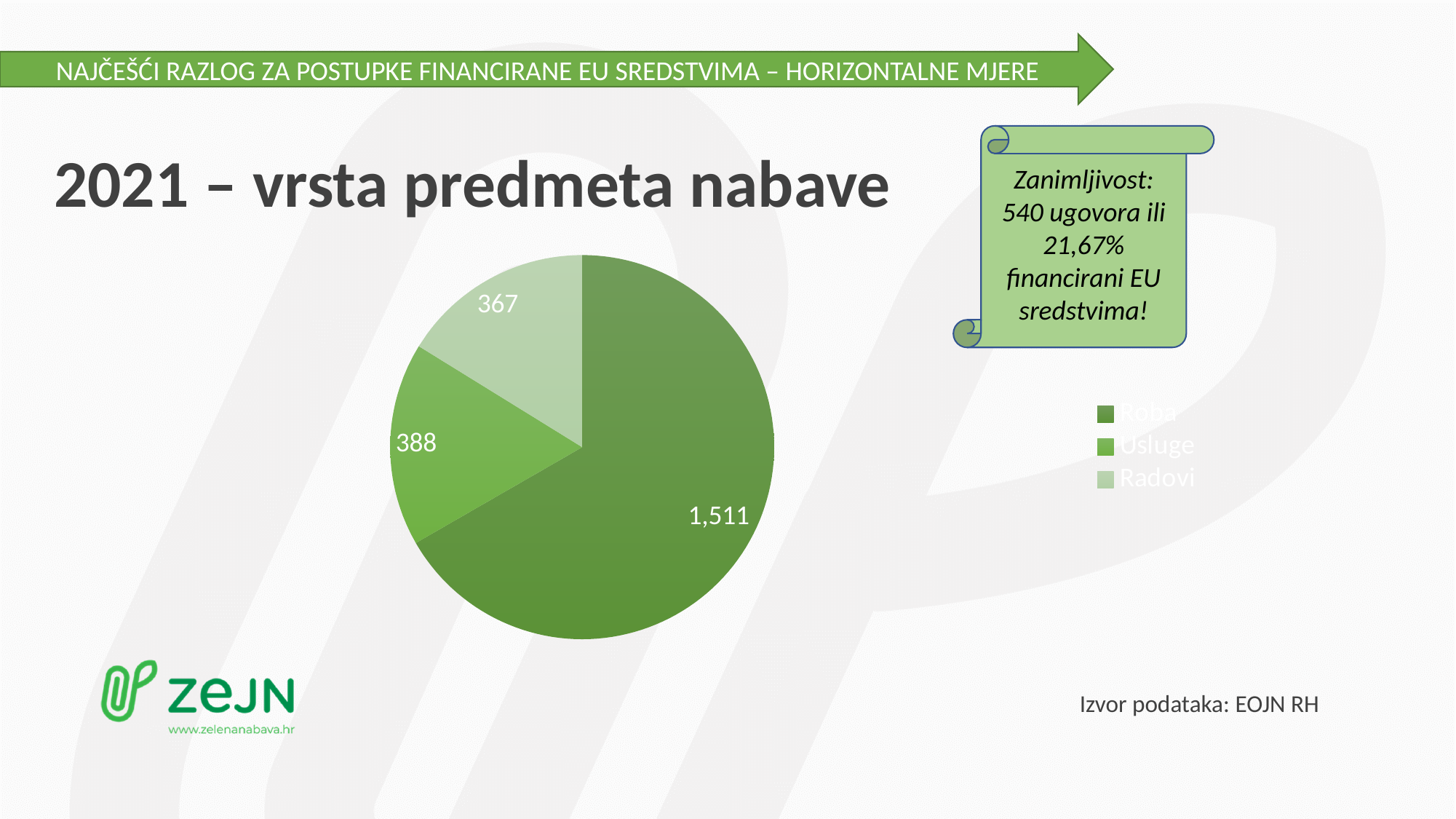
Which is larger, the value for Usluge or the value for Radovi? Usluge How many entries does the legend of the pie chart list? 3 What is the value for Radovi in the pie chart? 367 What kind of chart is shown on the slide? pie chart Which category has the smallest slice in the pie chart? Radovi Which category has the largest slice in the pie chart? Roba What is the title of the chart on the slide? 2021 – vrsta predmeta nabave What is the difference between the values for Roba and Usluge? 1,123 How many slices does the pie chart have? 3 What is the difference between the values for Usluge and Radovi? 21 What is the value for Usluge in the pie chart? 388 What is the value for Roba in the pie chart? 1,511